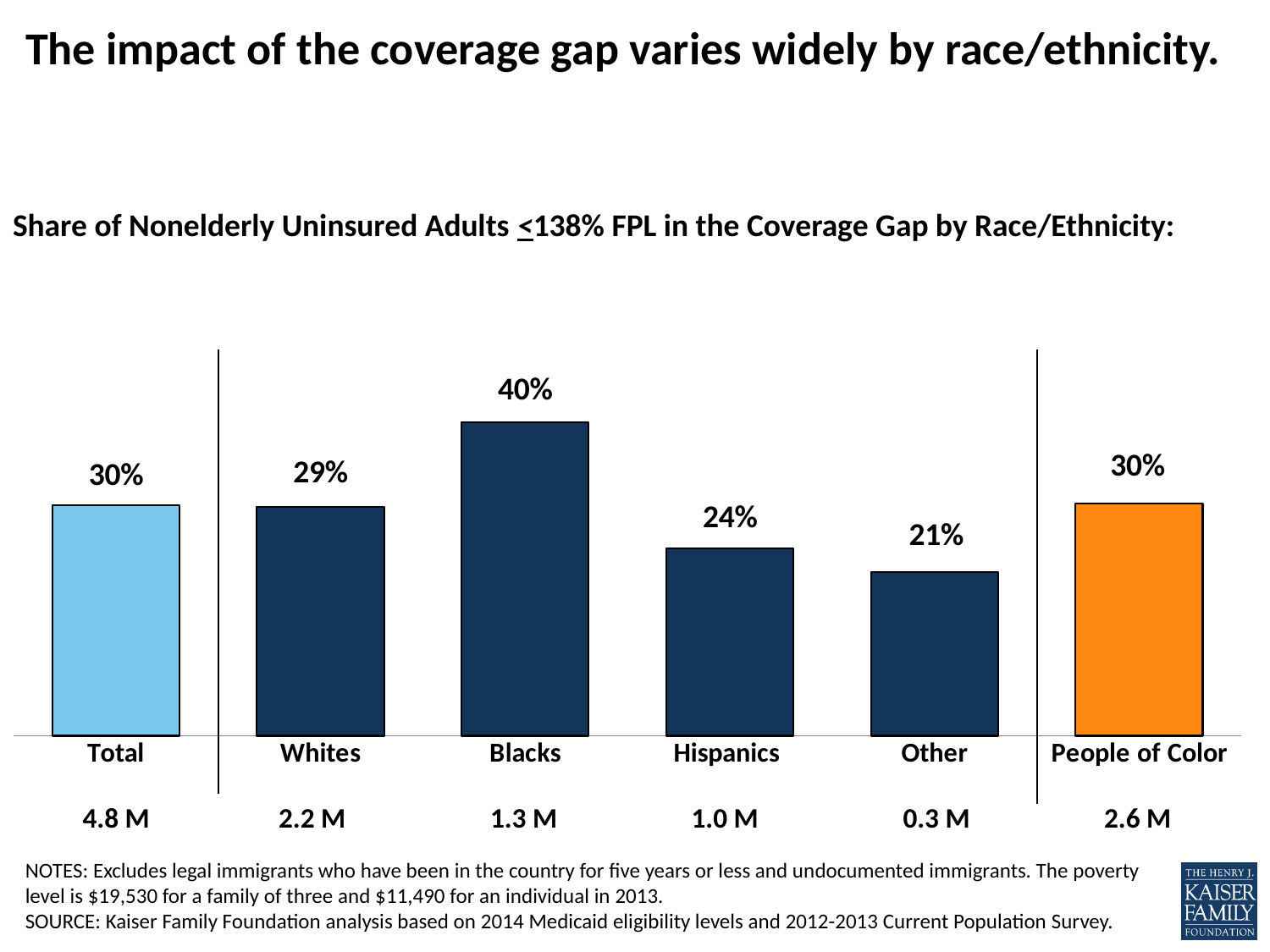
Which is larger, the value for Whites or the value for Hispanics? Whites Which category has the highest value? Blacks What is the difference between the values for Hispanics and Other? 3% What is the value for Hispanics? 24% What kind of chart is shown on the slide? Bar chart How many bars are shown in the chart? 6 What is the value for Blacks? 40% What is the difference between the values for Blacks and Whites? 11% What colour is the bar for People of Color? Orange Which category has the lowest value? Other What is the value for Other? 21% What is the value for Whites? 29%